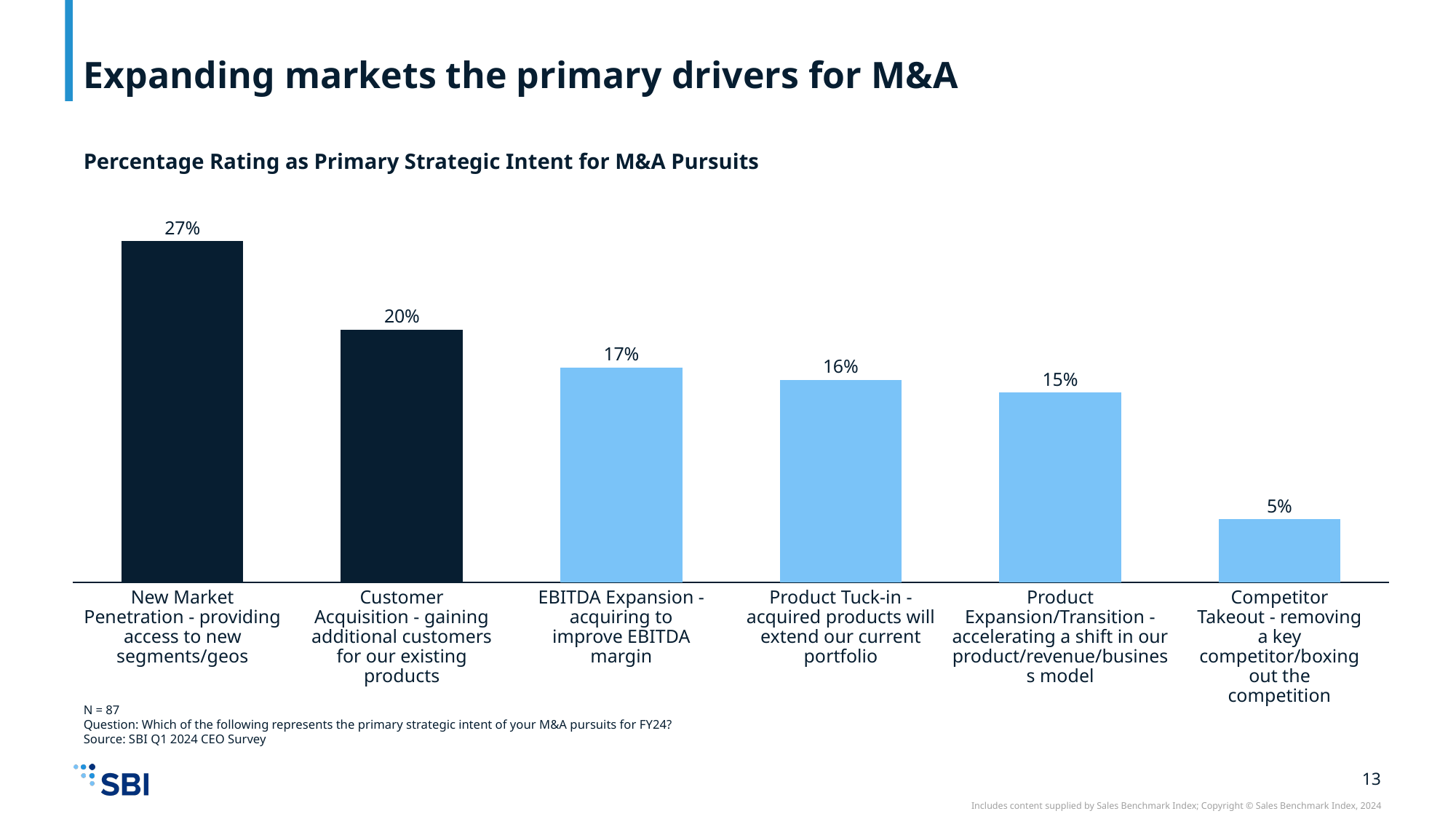
Which category has the lowest percentage rating? Competitor Takeout What is the difference in percentage points between New Market Penetration and Customer Acquisition? 7 Which is larger, the value for Product Tuck-in or the value for Product Expansion/Transition? Product Tuck-in What is the value for Competitor Takeout? 5% What percentage of respondents rated New Market Penetration as their primary strategic intent for M&A pursuits? 27% What percentage is shown for EBITDA Expansion? 17% What is the sample size (N) noted below the chart? 87 What is the value shown for Customer Acquisition? 20% What is the difference between Product Tuck-in and Competitor Takeout? 11% What kind of chart is shown on the slide? Bar chart How many categories are shown in the chart? 6 Which category has the highest percentage rating as primary strategic intent? New Market Penetration